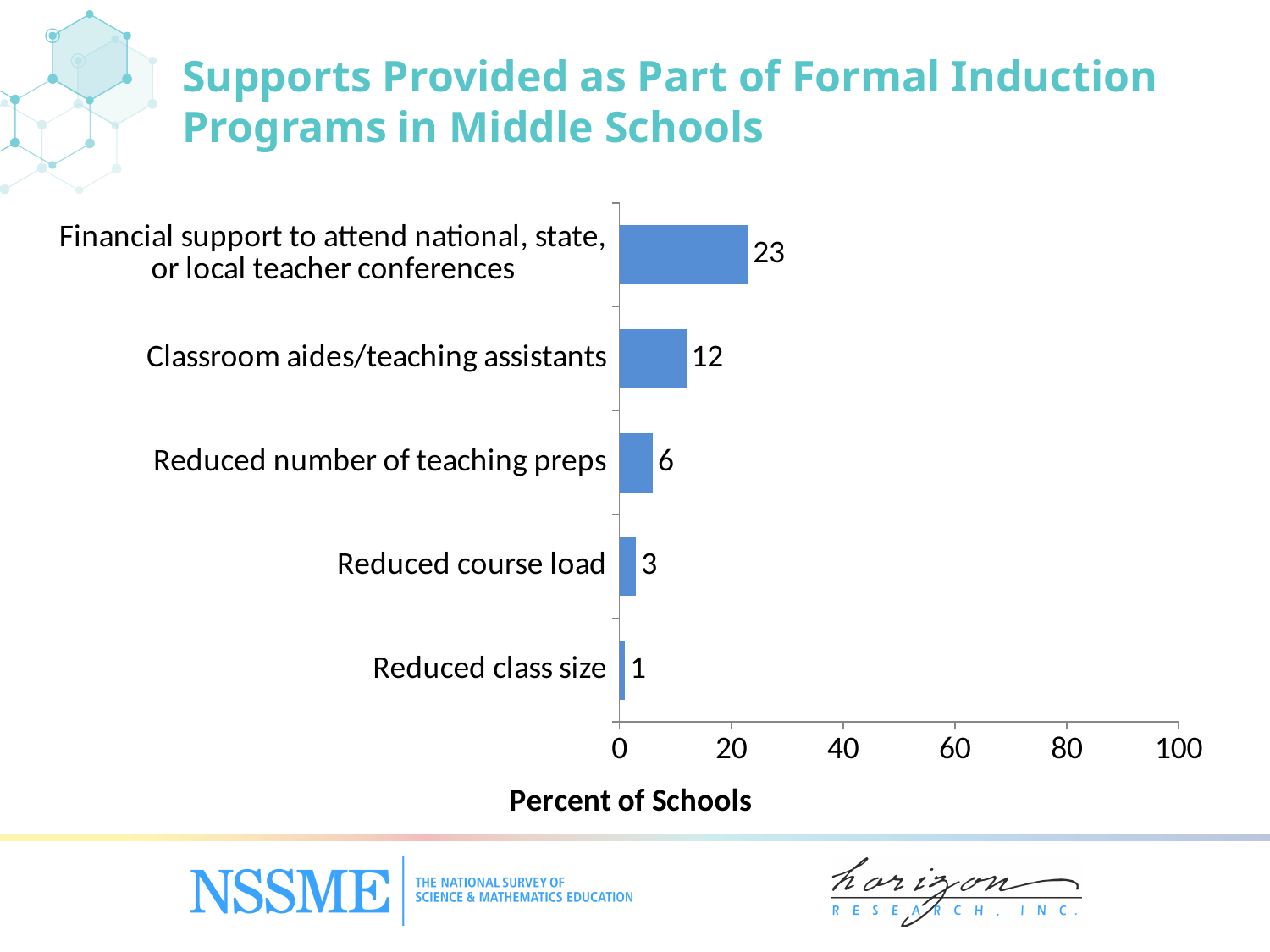
What percent of middle schools provide financial support to attend national, state, or local teacher conferences as part of formal induction programs? 23 Which is larger: the value for Reduced number of teaching preps or the value for Reduced course load? Reduced number of teaching preps What is the value for Reduced number of teaching preps? 6 What is the difference between the values for Classroom aides/teaching assistants and Reduced course load? 9 What is the value for Reduced class size? 1 How many supports are shown in the chart? 5 Which support has the highest percent of schools? Financial support to attend national, state, or local teacher conferences What is the label of the horizontal axis? Percent of Schools What is the value for Classroom aides/teaching assistants? 12 Is the value for Financial support to attend national, state, or local teacher conferences greater or less than 20? greater Which support has the lowest percent of schools? Reduced class size What kind of chart is shown on the slide? bar chart